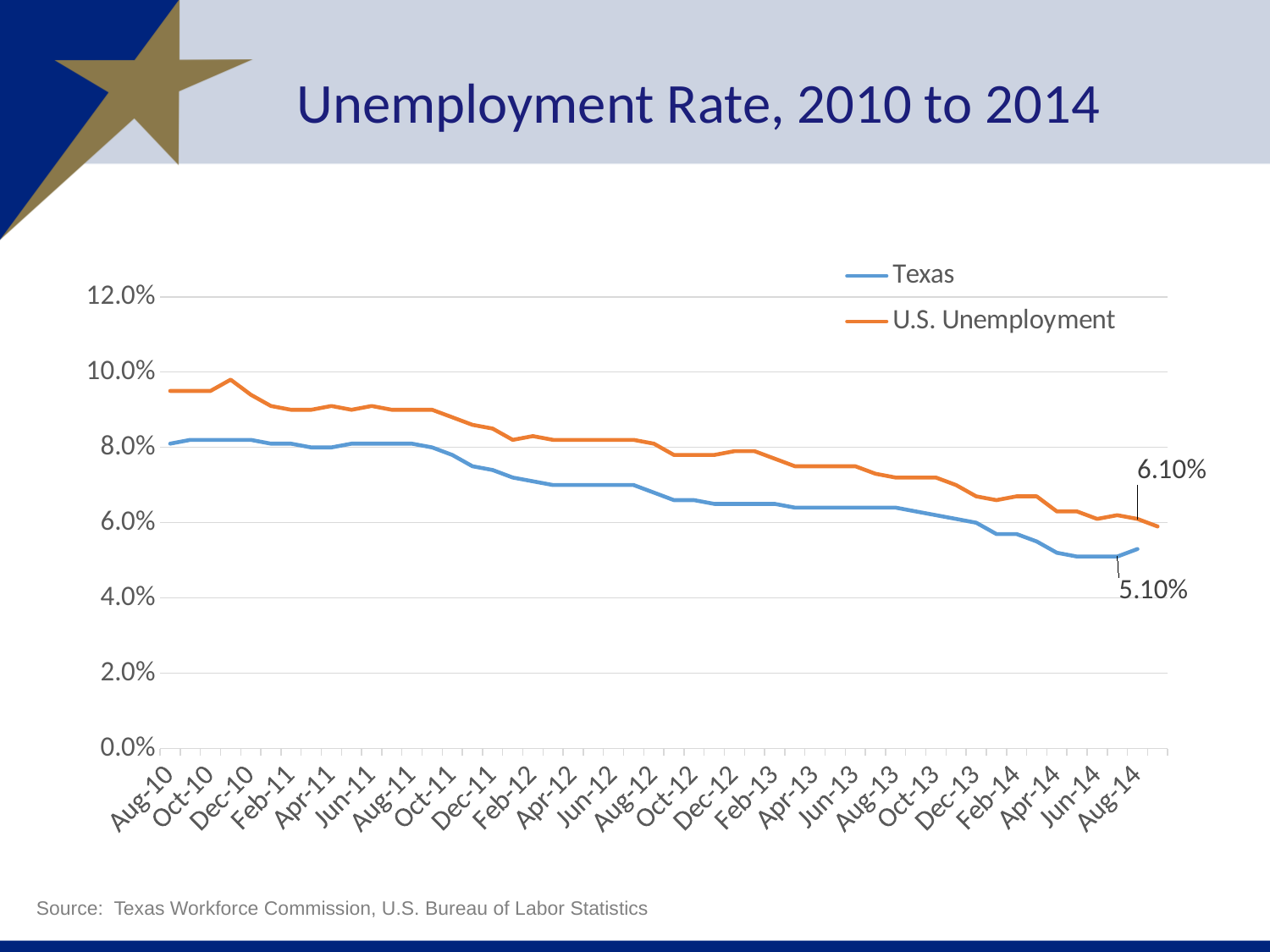
What is the difference between the two labeled values, 6.10% for U.S. Unemployment and 5.10% for Texas? 1.00% Is the Texas value for Aug-14 greater or less than 6.0%? less Is the U.S. Unemployment value for Aug-10 greater or less than 9.0%? greater Is the Texas value for Dec-12 greater or less than 7.0%? less What kind of chart is shown on the slide? line chart How many series does the legend list? 2 What are the two series named in the legend? Texas and U.S. Unemployment What value is printed as a data label on the Texas line? 5.10% Do the unemployment rates generally rise or fall from Aug-10 to Aug-14? fall Which series is higher throughout the period, Texas or U.S. Unemployment? U.S. Unemployment What value is printed as a data label on the U.S. Unemployment line? 6.10% What is the title of the chart? Unemployment Rate, 2010 to 2014